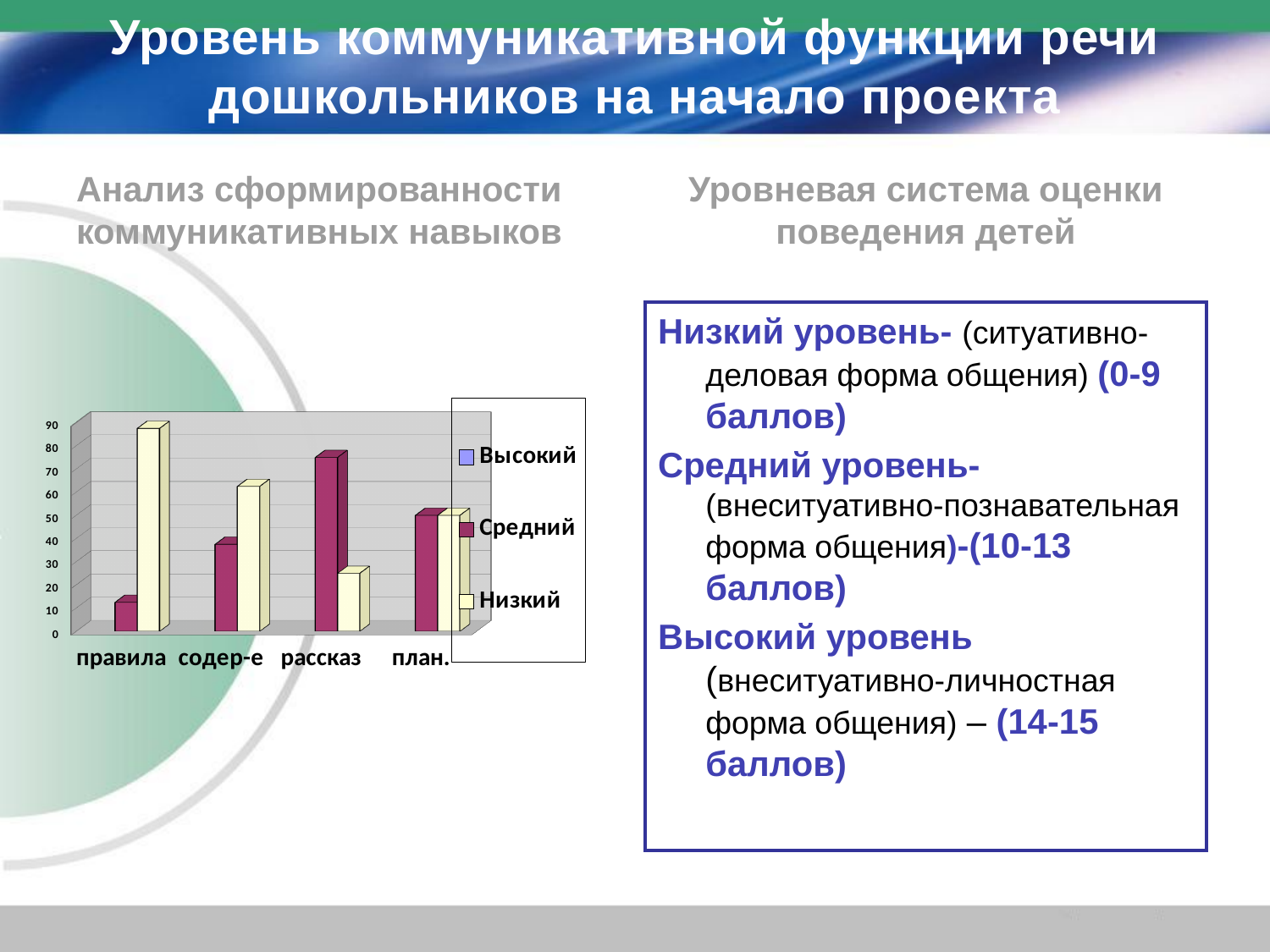
Is the value of the Низкий series for правила greater or less than 80? greater For рассказ, which series has the larger value, Средний or Низкий? Средний For which category is the Средний series lowest? правила Is the value of the Средний series for правила greater or less than 20? less Which series are listed in the chart legend? Высокий, Средний, Низкий Is the value of the Низкий series for рассказ greater or less than 30? less What kind of chart is shown on the slide? bar chart How many series does the chart legend list? 3 For which category is the Низкий series highest? правила How many categories are shown on the x axis of the chart? 4